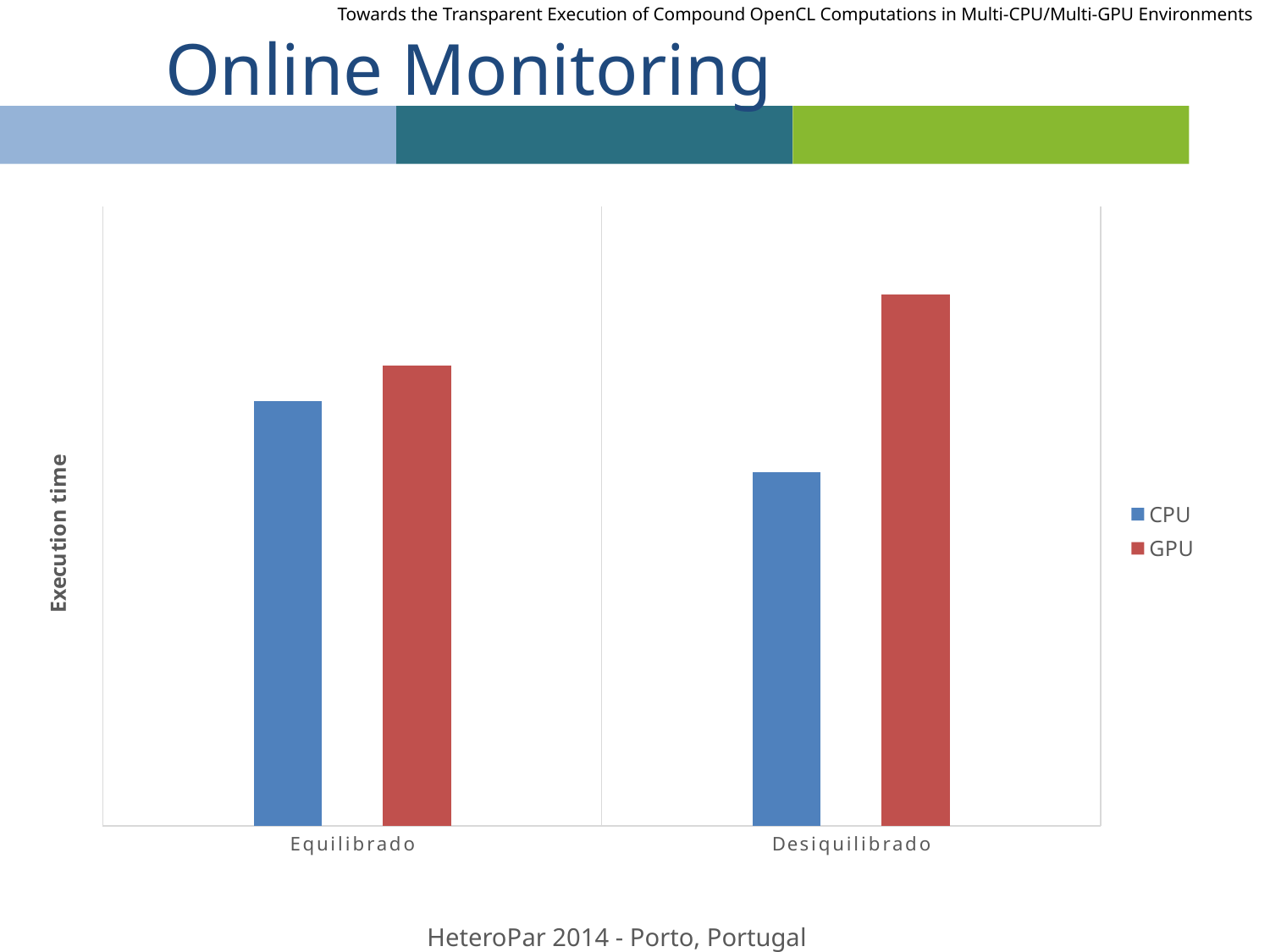
For Equilibrado, which is larger: the CPU bar or the GPU bar? GPU How many series does the chart's legend list? 2 Does the CPU execution time rise or fall from Equilibrado to Desiquilibrado? Fall Which bar is the tallest in the chart? GPU for Desiquilibrado For Desiquilibrado, which is larger: the CPU bar or the GPU bar? GPU Which category has the lower CPU execution time? Desiquilibrado Which series are listed in the chart's legend? CPU and GPU Which category has the higher GPU execution time? Desiquilibrado How many categories are shown on the x axis of the chart? 2 What kind of chart is shown on the slide? Bar chart What is the label of the vertical axis of the chart? Execution time Does the GPU execution time rise or fall from Equilibrado to Desiquilibrado? Rise